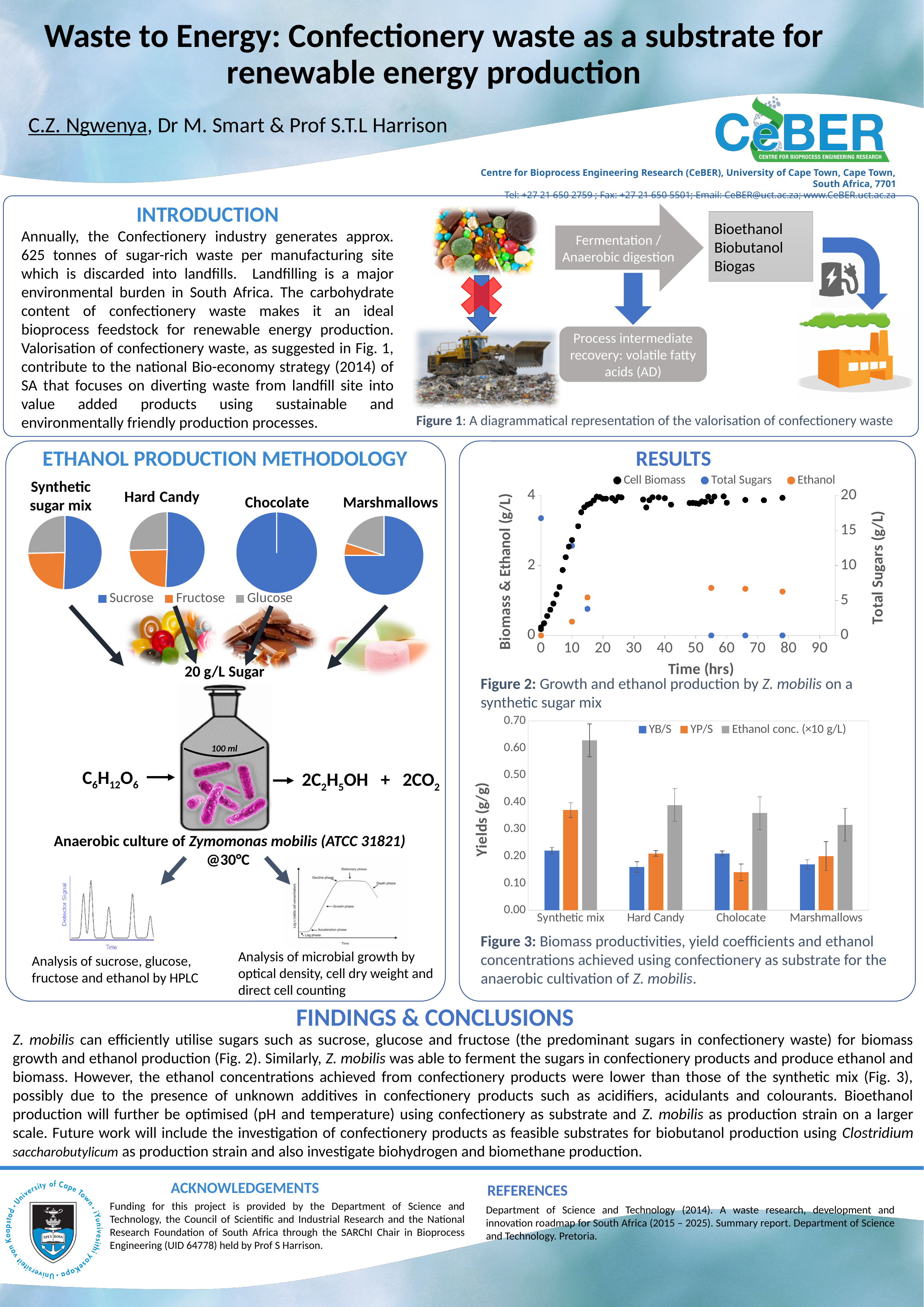
In Figure 2, is the Total Sugars value at time 0 hrs greater or less than 15 g/L? greater In Figure 3, for Synthetic mix, which is larger: YB/S or YP/S? YP/S In Figure 3, is the YP/S value for Cholocate greater or less than 0.20? less Among the four pie charts in the Ethanol Production Methodology section, which confectionery has the largest Sucrose share? Chocolate How many substrate categories are shown on the x axis of Figure 3? 4 In Figure 2, does the Total Sugars series rise or fall over time? fall What kind of chart is Figure 3 (Biomass productivities, yield coefficients and ethanol concentrations)? bar chart In Figure 3, is the Ethanol conc. (×10 g/L) value for Synthetic mix greater or less than 0.50? greater How many series does the legend of Figure 3 list? 3 In Figure 3, which substrate has the highest YP/S bar? Synthetic mix In Figure 3, which substrate has the highest Ethanol conc. (×10 g/L) bar? Synthetic mix How many series does the legend of Figure 2 (Growth and ethanol production by Z. mobilis) list? 3